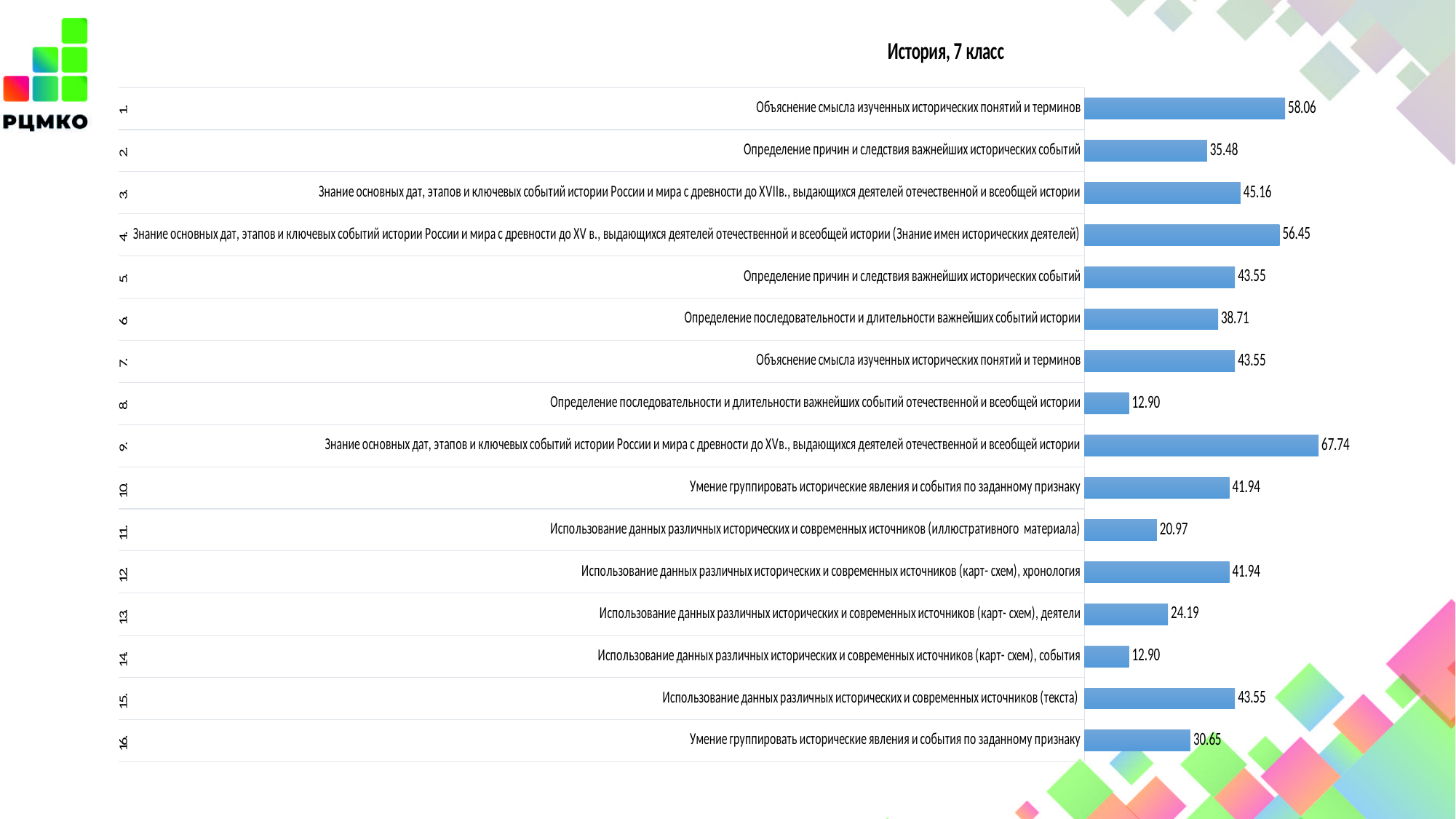
What is the value for item 1, "Объяснение смысла изученных исторических понятий и терминов"? 58.06 What is the title of the chart? История, 7 класс What is the difference between the value for item 1 (58.06) and item 2 (35.48)? 22.58 What is the difference between the value for item 9 (67.74) and item 8 (12.90)? 54.84 What is the value for item 13, "Использование данных различных исторических и современных источников (карт- схем), деятели"? 24.19 What type of chart is shown on the slide? bar chart Which has the larger value: item 3 (до XVIIв.) or item 4 (до XV в., Знание имен исторических деятелей)? item 4 What is the value for item 16, "Умение группировать исторические явления и события по заданному признаку"? 30.65 Which numbered item has the highest value? 9 What is the lowest value shown on the chart? 12.90 How many categories (bars) does the chart show? 16 What is the value for item 11, "Использование данных различных исторических и современных источников (иллюстративного материала)"? 20.97